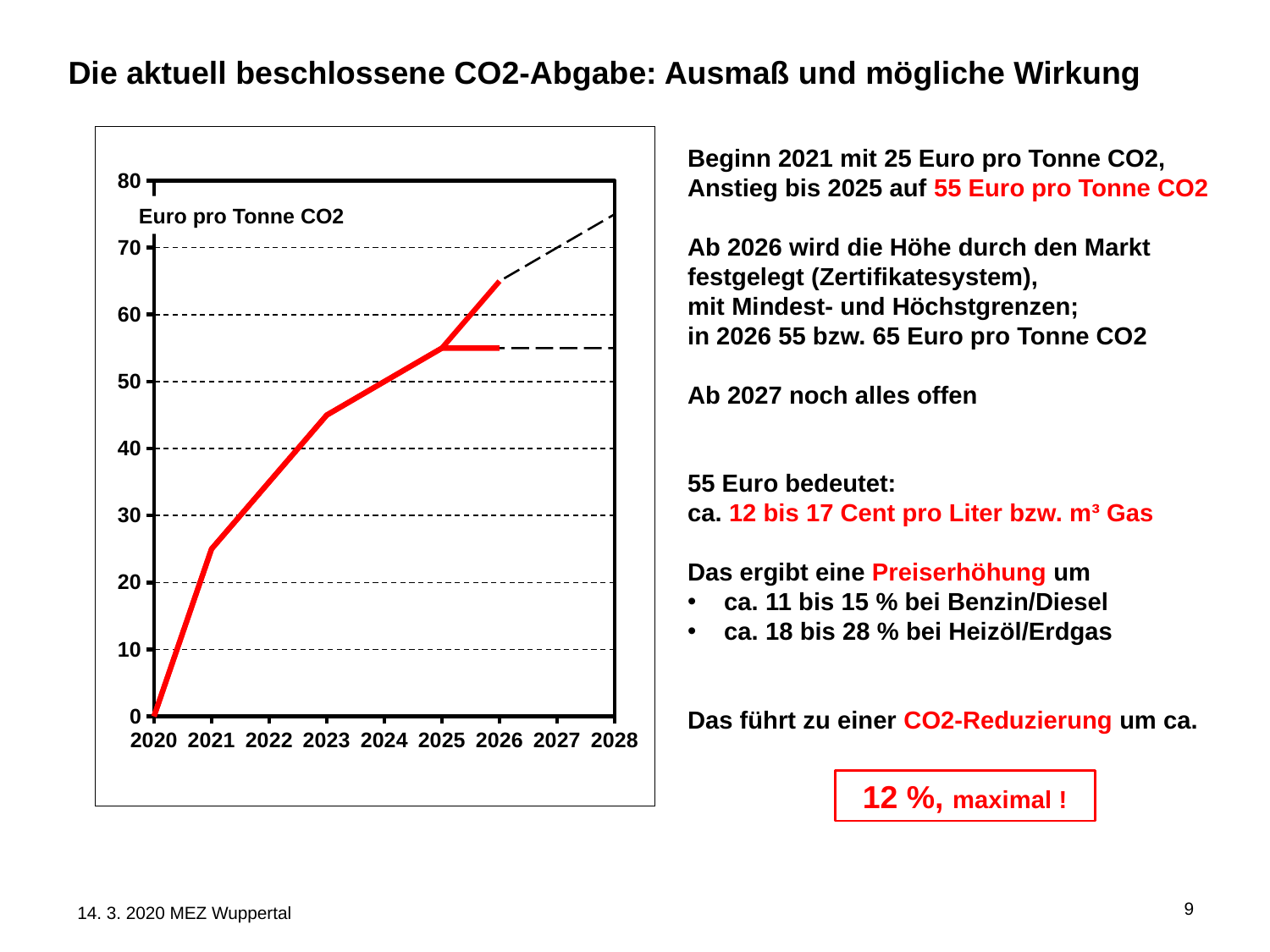
What is the value for 2020 in the chart? 0 Is the value for 2023 greater or less than 40? greater What is the value for 2024 in the chart? 50 What unit label is shown inside the chart area? Euro pro Tonne CO2 Which year has the larger value, 2021 or 2023? 2023 Is the value for 2025 greater or less than 60? less Is the value for 2022 greater or less than 40? less How many years are labelled on the x axis? 9 What is the value for 2021 in the chart (Euro pro Tonne CO2)? 25 What kind of chart is shown on the slide? line chart Do the values rise or fall from 2020 to 2025? rise